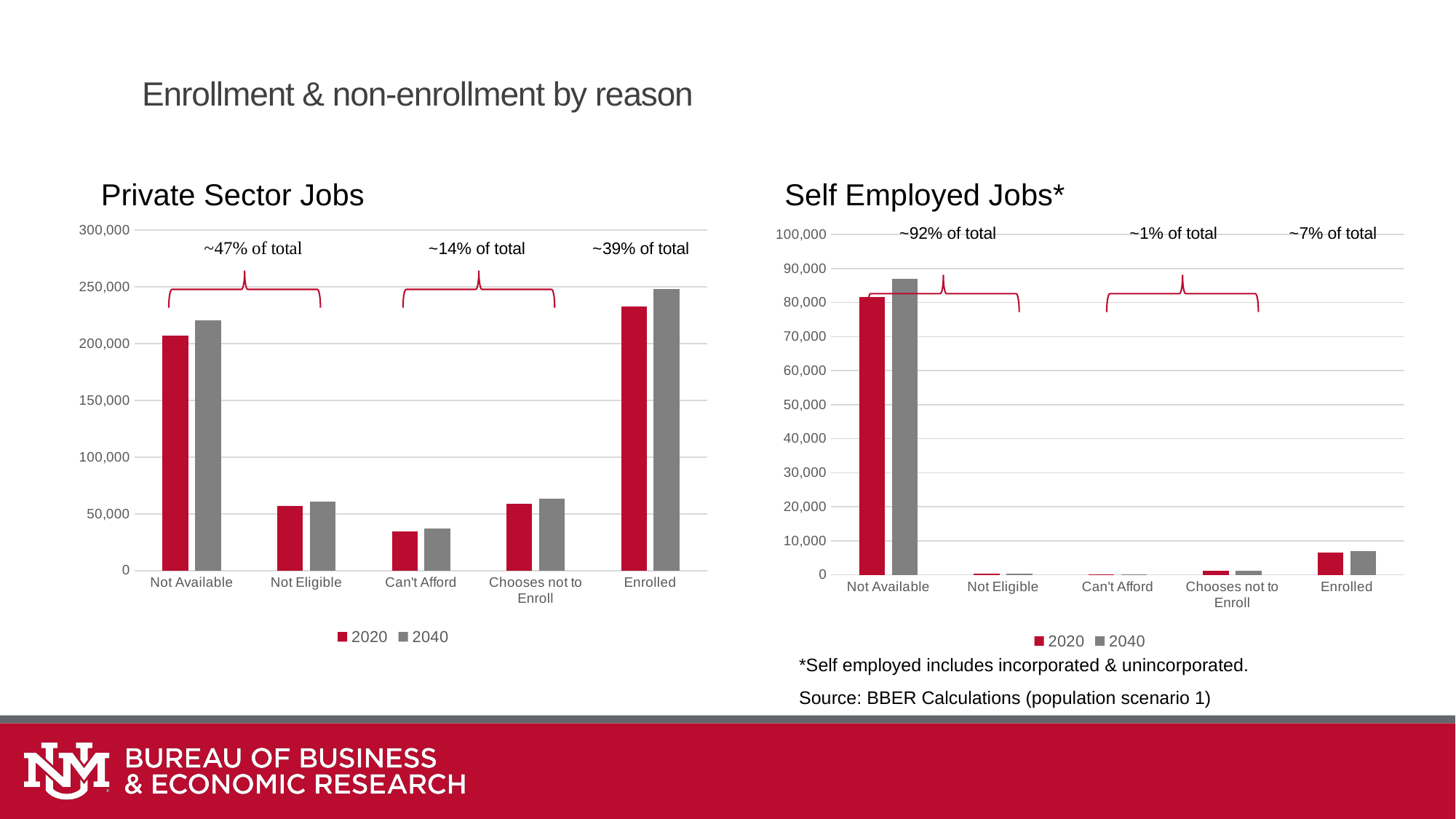
How many series does the legend of the Self Employed Jobs chart list? 2 What kind of chart is the Private Sector Jobs chart? bar chart How many categories are shown on the x axis of the Private Sector Jobs chart? 5 In the Private Sector Jobs chart, which category has the highest value for 2040? Enrolled In the Private Sector Jobs chart, is the 2020 value for Not Eligible greater or less than 50,000? greater In the Self Employed Jobs chart, is the 2040 value for Not Available greater or less than 80,000? greater In the Self Employed Jobs chart, is the 2020 value for Enrolled greater or less than 10,000? less In the Private Sector Jobs chart, which category has the lowest value for 2020? Can't Afford In the Private Sector Jobs chart, which is larger for 2020: Enrolled or Not Available? Enrolled In the Self Employed Jobs chart, which category has the highest value for 2020? Not Available In the Self Employed Jobs chart, what share of the total is annotated above the Not Available category? ~92% of total